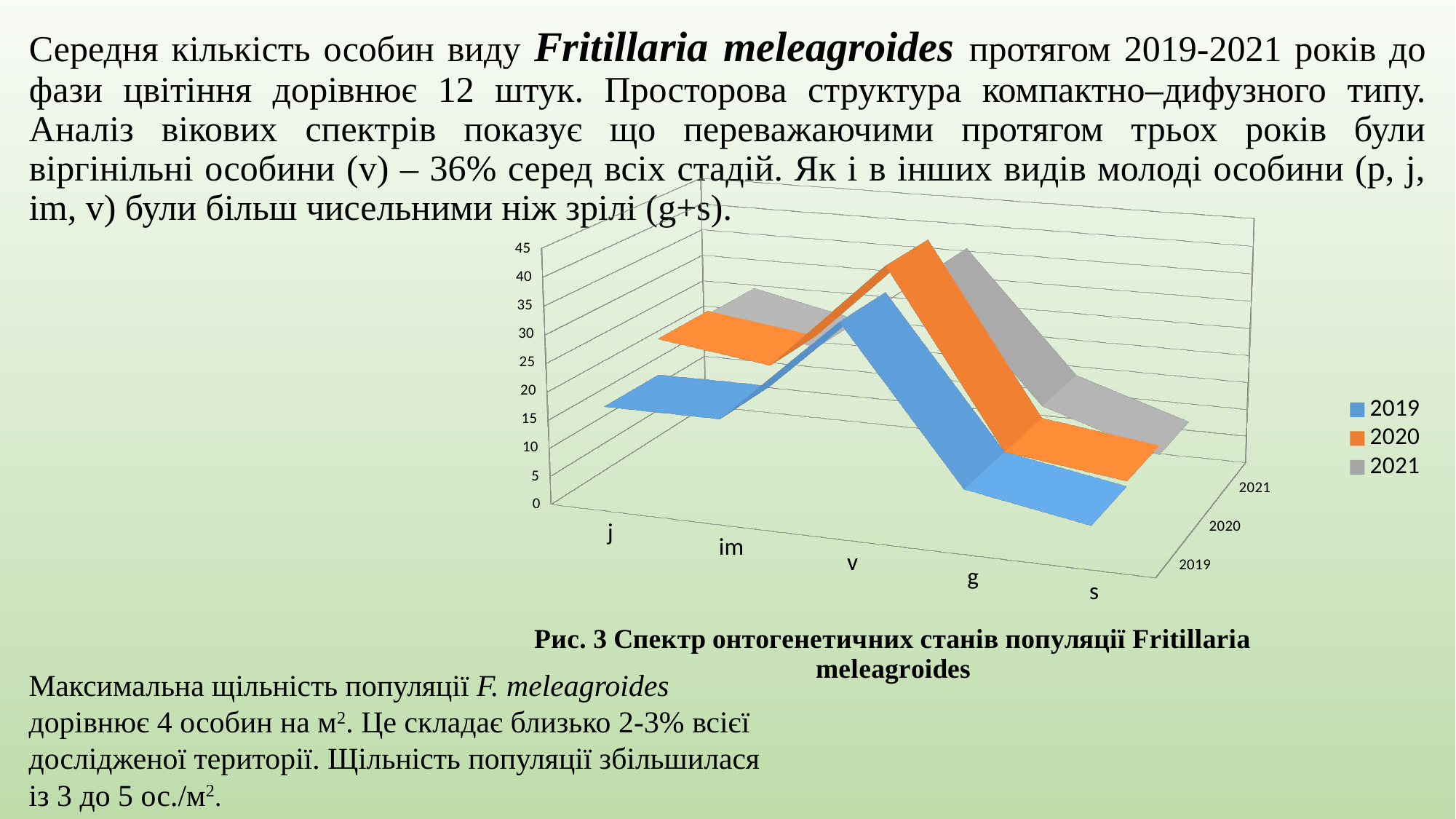
Which category has the lowest value for the 2019 series? s For the 2019 series, which is larger: the value for v or the value for s? v Is the value for j in the 2019 series greater or less than 30? less How many series does the chart legend list? 3 How many categories are shown along the x axis of the chart? 5 Do the values for the 2019 series rise or fall from v to s along the x axis? fall Which series are listed in the chart legend? 2019, 2020, 2021 What is the maximum value shown on the vertical axis of the chart? 45 Which category has the highest value for the 2020 series? v Which category has the highest value for the 2019 series? v What kind of chart is shown on the slide? 3D line chart Is the value for v in the 2019 series greater or less than 20? greater